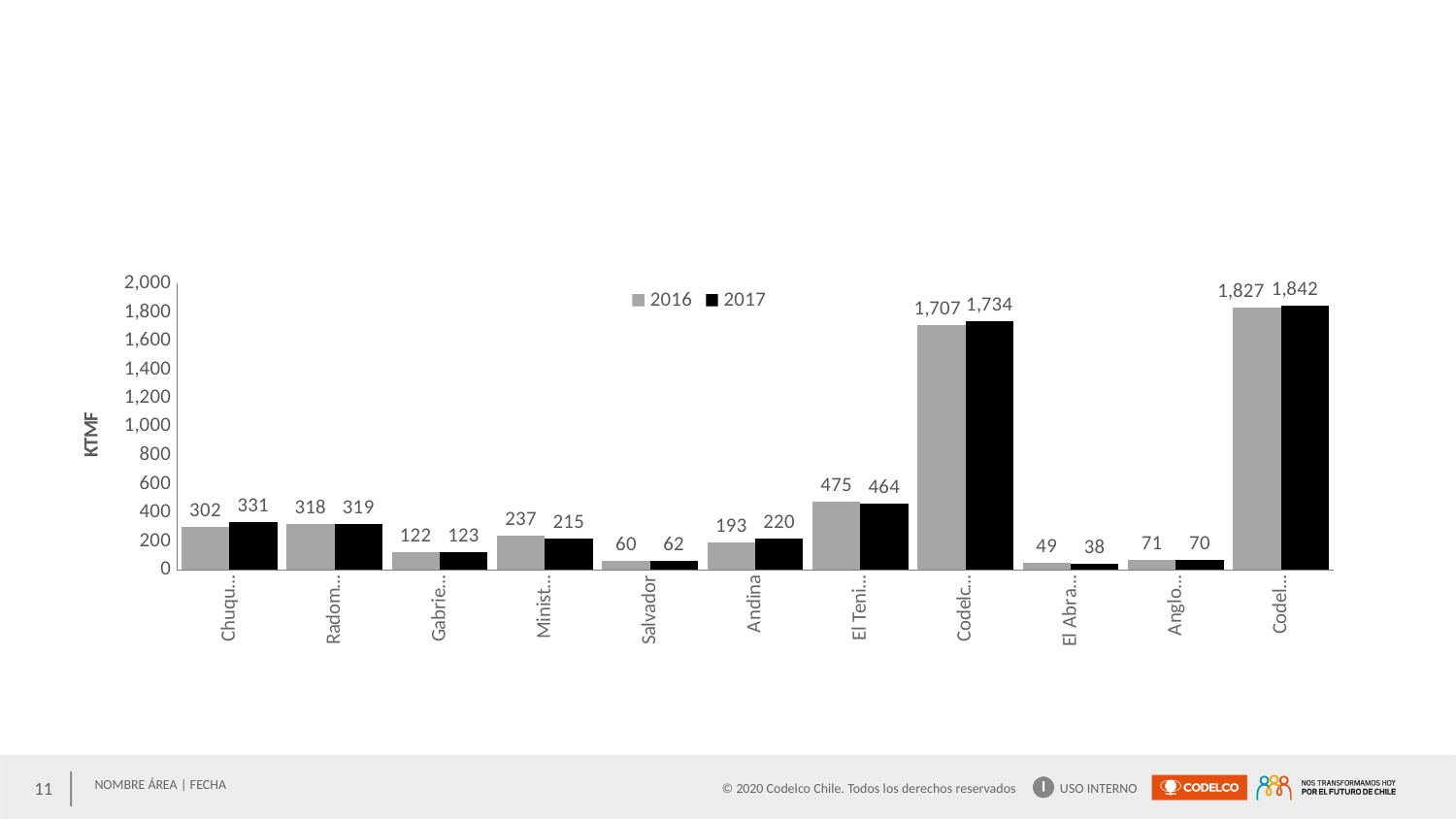
What is the highest 2016 value shown on the chart? 1,827 What is the label on the y axis? KTMF For Salvador, which year has the larger value, 2016 or 2017? 2017 What is the 2016 value for Salvador? 60 How many categories are shown along the x axis? 11 What is the 2017 value for Andina? 220 What are the two entries in the legend? 2016 and 2017 What is the 2016 value for the category labelled 'El Teni...'? 475 What is the lowest 2017 value shown on the chart? 38 How many series does the legend list? 2 What kind of chart is shown on the slide? bar chart What is the difference between the 2017 and 2016 values for Andina? 27